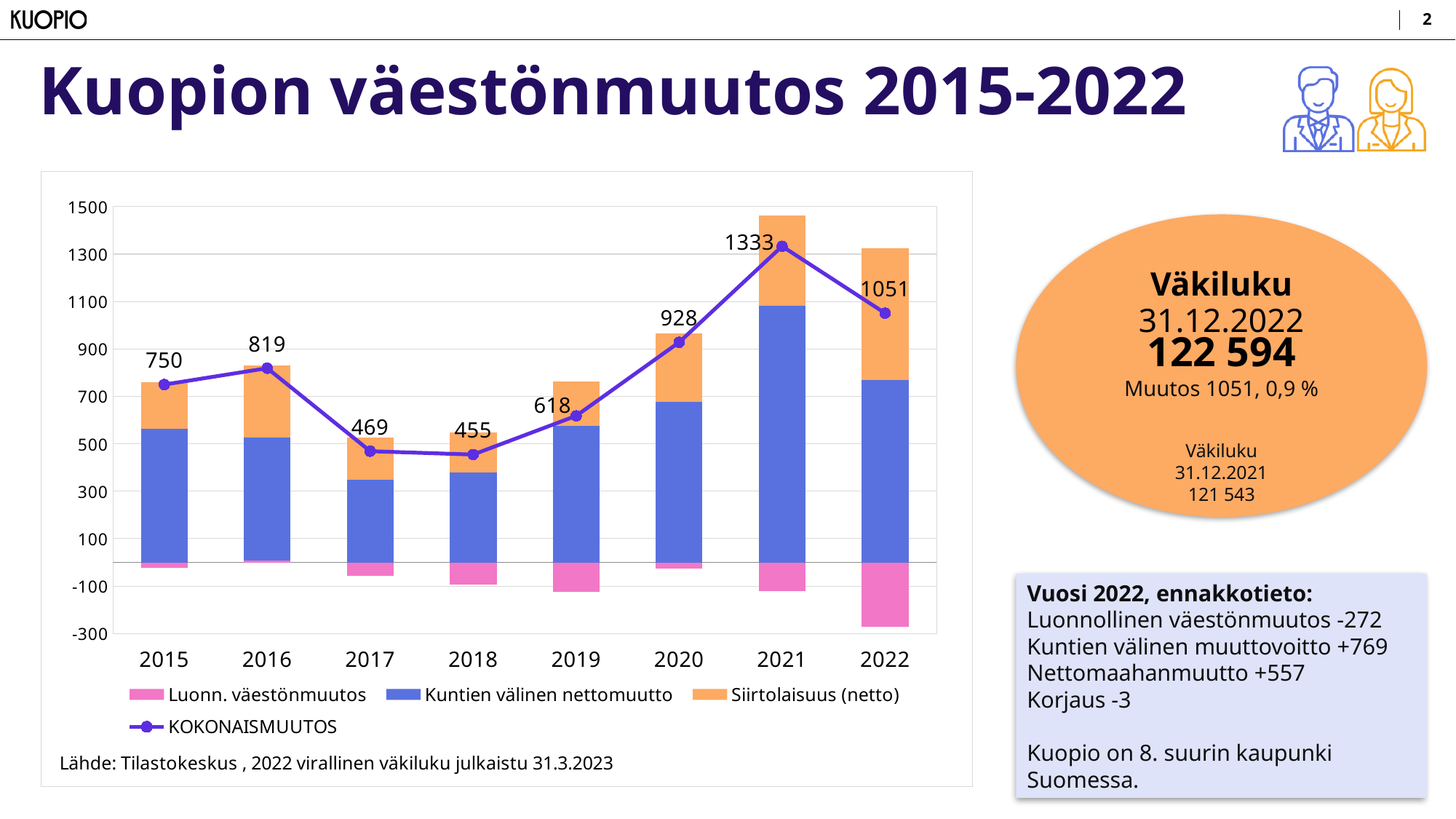
Does the KOKONAISMUUTOS line rise or fall from 2018 to 2021? Rise Which is larger, the KOKONAISMUUTOS value for 2016 or for 2019? 2016 What is the KOKONAISMUUTOS value for 2015? 750 How many years are shown on the x axis of the chart? 8 What is the KOKONAISMUUTOS value for 2021? 1333 What is the KOKONAISMUUTOS value for 2018? 455 Which year has the highest KOKONAISMUUTOS value? 2021 What kind of chart is shown on the slide? Stacked bar chart with a line Is the Kuntien välinen nettomuutto value for 2021 greater or less than 900? greater How many series does the chart legend list? 4 Which year has the lowest KOKONAISMUUTOS value? 2018 What is the difference between the KOKONAISMUUTOS values for 2021 and 2022? 282